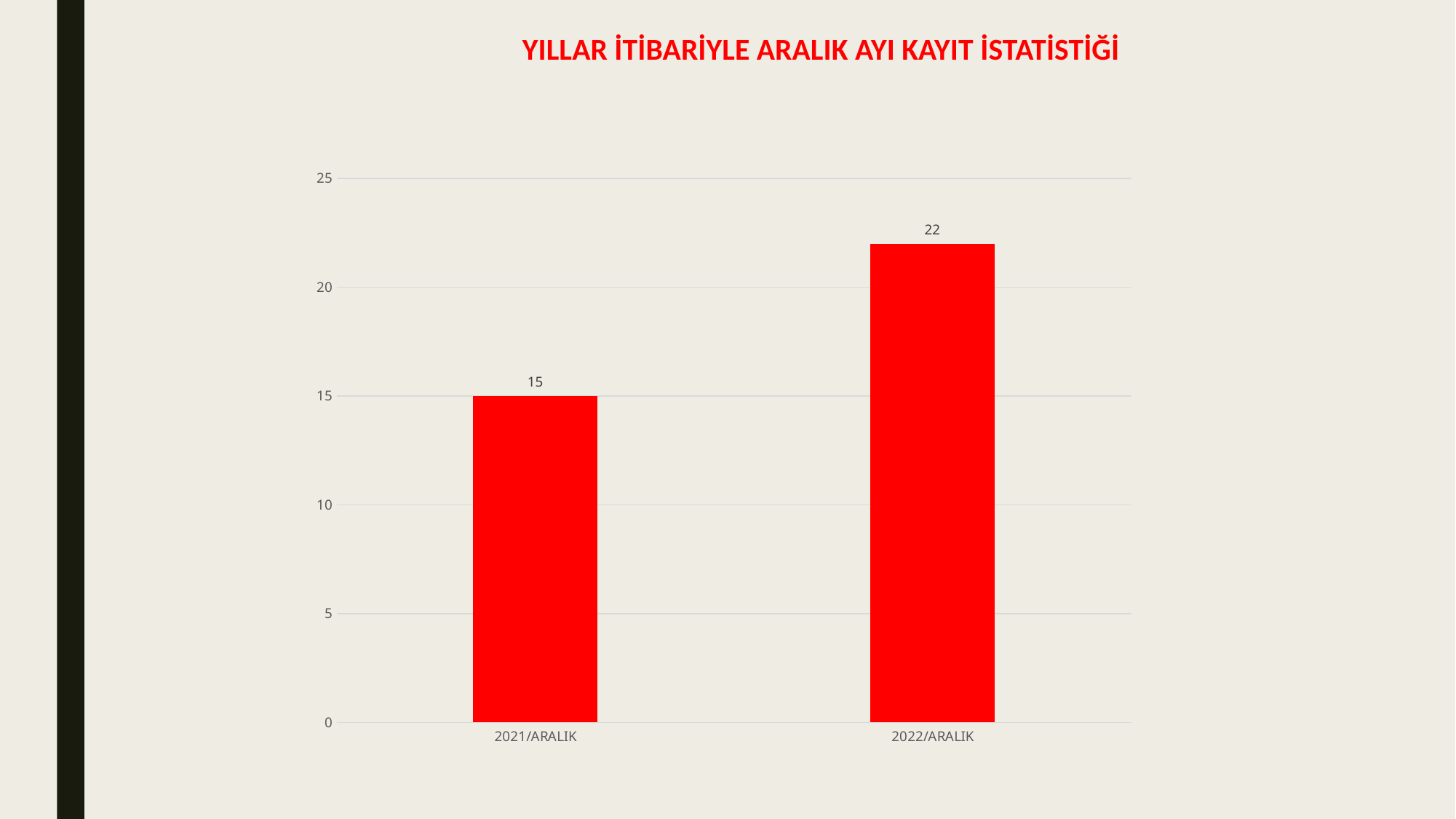
Is the value for 2021/ARALIK greater or less than 20? less What is the value for 2022/ARALIK? 22 What is the title of the chart? YILLAR İTİBARİYLE ARALIK AYI KAYIT İSTATİSTİĞİ What kind of chart is shown on the slide? bar chart What is the difference between the values for 2022/ARALIK and 2021/ARALIK? 7 Which is larger, the value for 2021/ARALIK or the value for 2022/ARALIK? 2022/ARALIK What is the value for 2021/ARALIK? 15 Do the values rise or fall from 2021/ARALIK to 2022/ARALIK? rise Is the value for 2022/ARALIK greater or less than 20? greater Which category has the highest value? 2022/ARALIK How many categories are shown on the x axis? 2 Which category has the lowest value? 2021/ARALIK